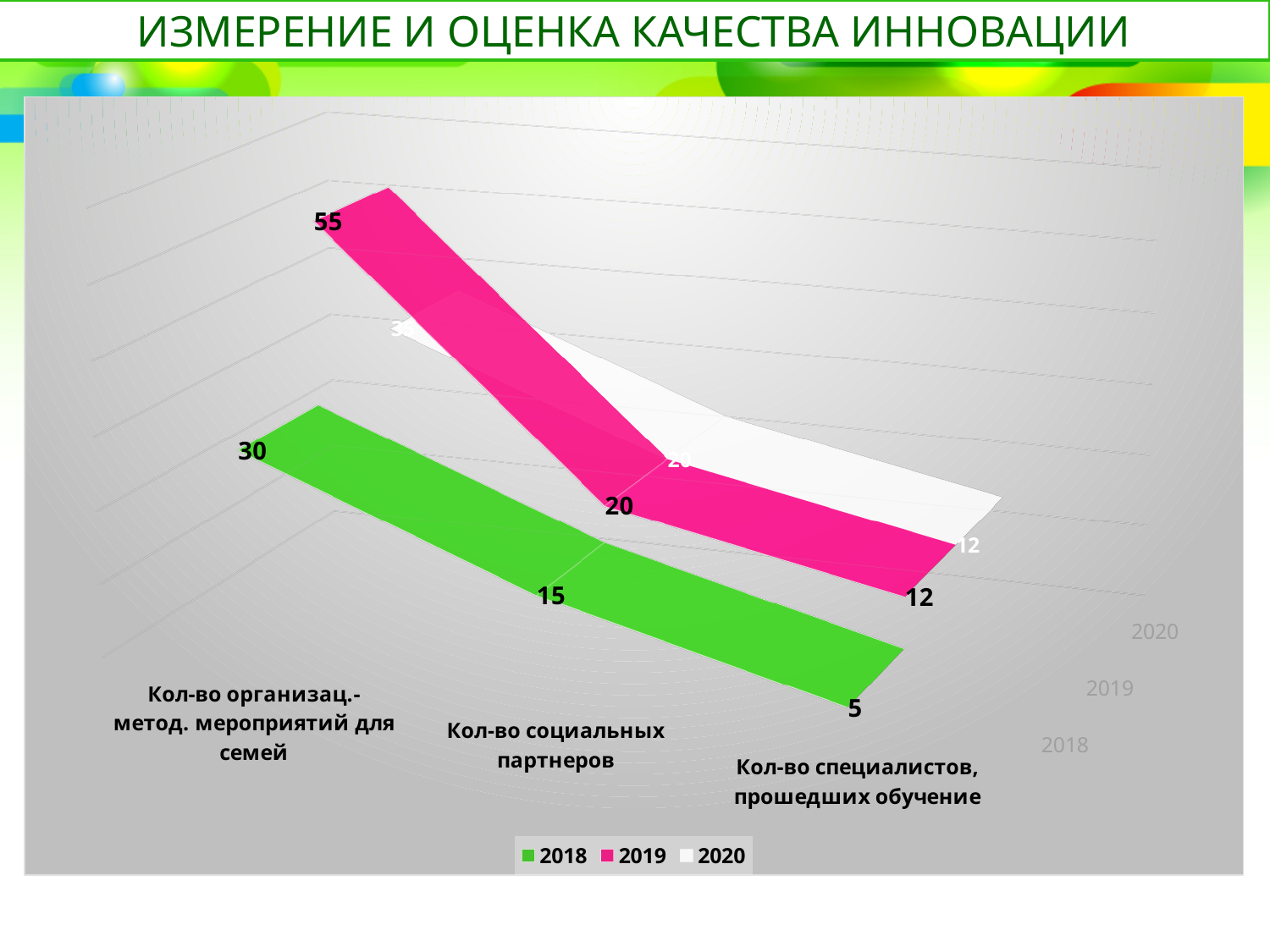
What is the difference between the 2019 and 2018 values for "Кол-во организац.-метод. мероприятий для семей"? 25 How many categories are shown on the x axis? 3 How many series does the legend list? 3 What is the value for 2018 for "Кол-во организац.-метод. мероприятий для семей"? 30 What is the value for 2019 for "Кол-во организац.-метод. мероприятий для семей"? 55 Which is larger for "Кол-во социальных партнеров": the 2018 value or the 2019 value? 2019 Do the values of the 2018 series rise or fall across the categories from left to right? fall Which category has the highest value in the 2019 series? Кол-во организац.-метод. мероприятий для семей What is the value for 2018 for "Кол-во специалистов, прошедших обучение"? 5 Which category has the lowest value in the 2018 series? Кол-во специалистов, прошедших обучение What is the value for 2019 for "Кол-во социальных партнеров"? 20 What is the value for 2020 for "Кол-во специалистов, прошедших обучение"? 12